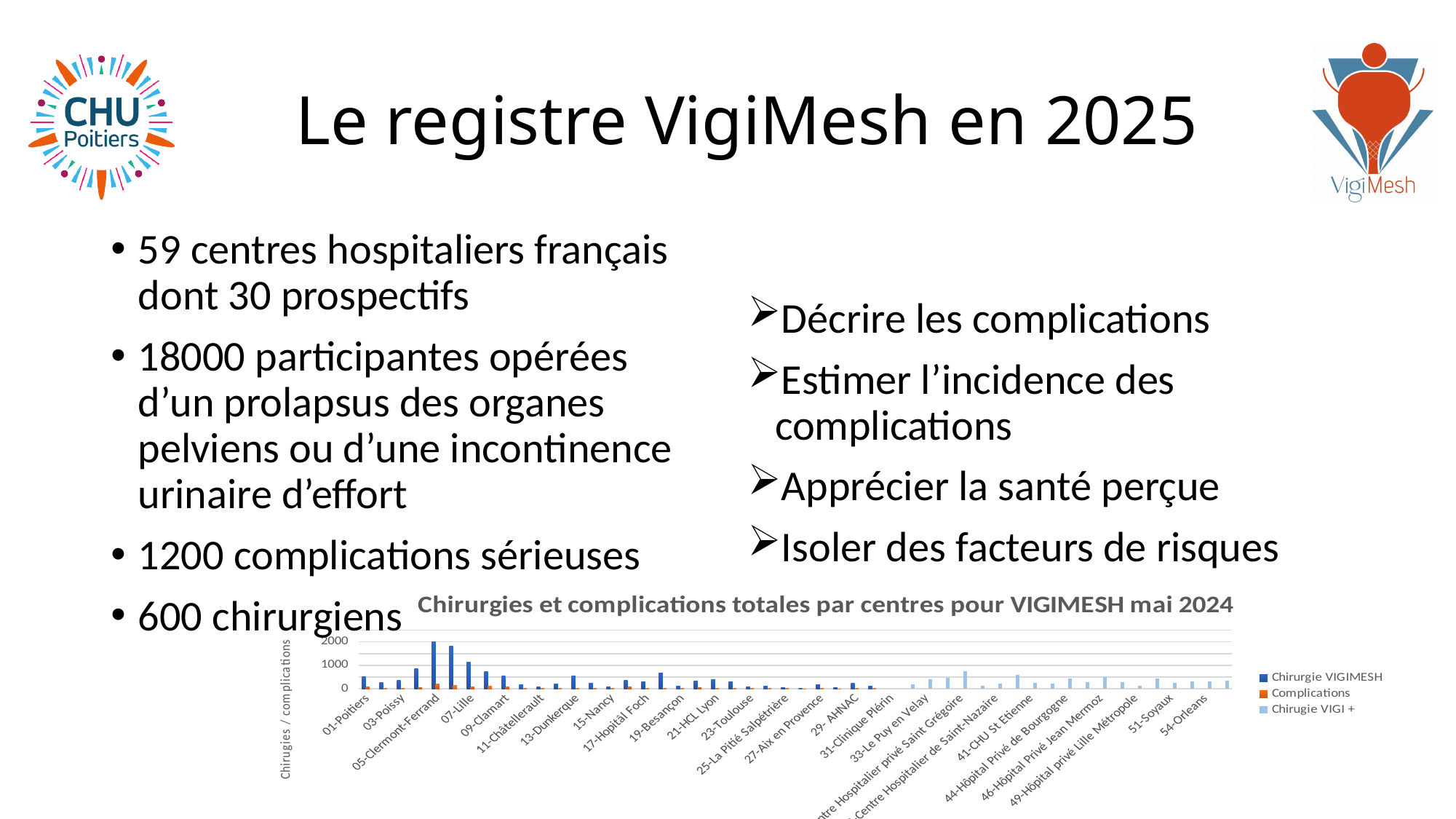
How many series does the chart legend list? 3 Which has the larger Chirurgie VIGIMESH value, 03-Poissy or 19-Besançon? 03-Poissy Is the Chirurgie VIGIMESH value for 01-Poitiers greater or less than 1000? less What type of chart is shown at the bottom of the slide? bar chart Is the Chirurgie VIGIMESH value for 05-Clermont-Ferrand greater or less than 1000? greater Which series in the chart is shown in orange? Complications Which has the larger Chirurgie VIGIMESH value, 01-Poitiers or 05-Clermont-Ferrand? 05-Clermont-Ferrand What is the highest tick value shown on the vertical axis of the chart? 2000 Which centre has the highest Chirurgie VIGIMESH value in the chart? 05-Clermont-Ferrand What is the title of the chart on the slide? Chirurgies et complications totales par centres pour VIGIMESH mai 2024 Is the Chirurgie VIGIMESH value for 03-Poissy greater or less than 1000? less